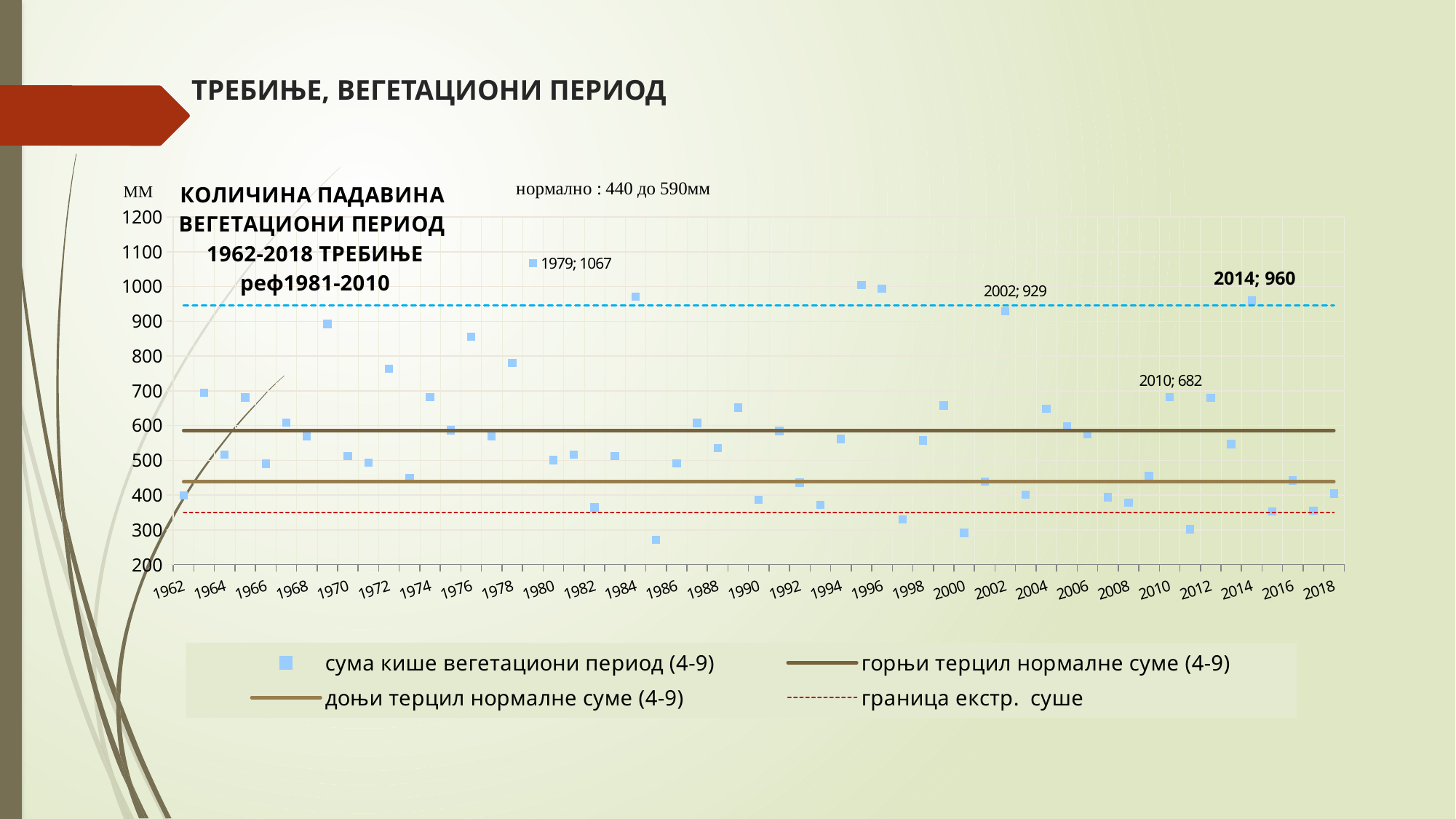
What value is labelled for the year 2002? 929 What value is labelled for the year 2010? 682 What normal range of precipitation is stated above the chart? 440 до 590мм How many entries does the legend list? 4 What kind of chart is shown on the slide? scatter chart Which is larger, the value for 2014 or the value for 2002? 2014 Which year has the highest precipitation sum in the vegetation period? 1979 What is the difference between the labelled values for 1979 and 2014? 107 What value is labelled for the year 2014? 960 What is the precipitation sum labelled for 1979? 1067 Is the value for 1985 greater or less than 300? less Is the value for 1969 greater or less than 800? greater